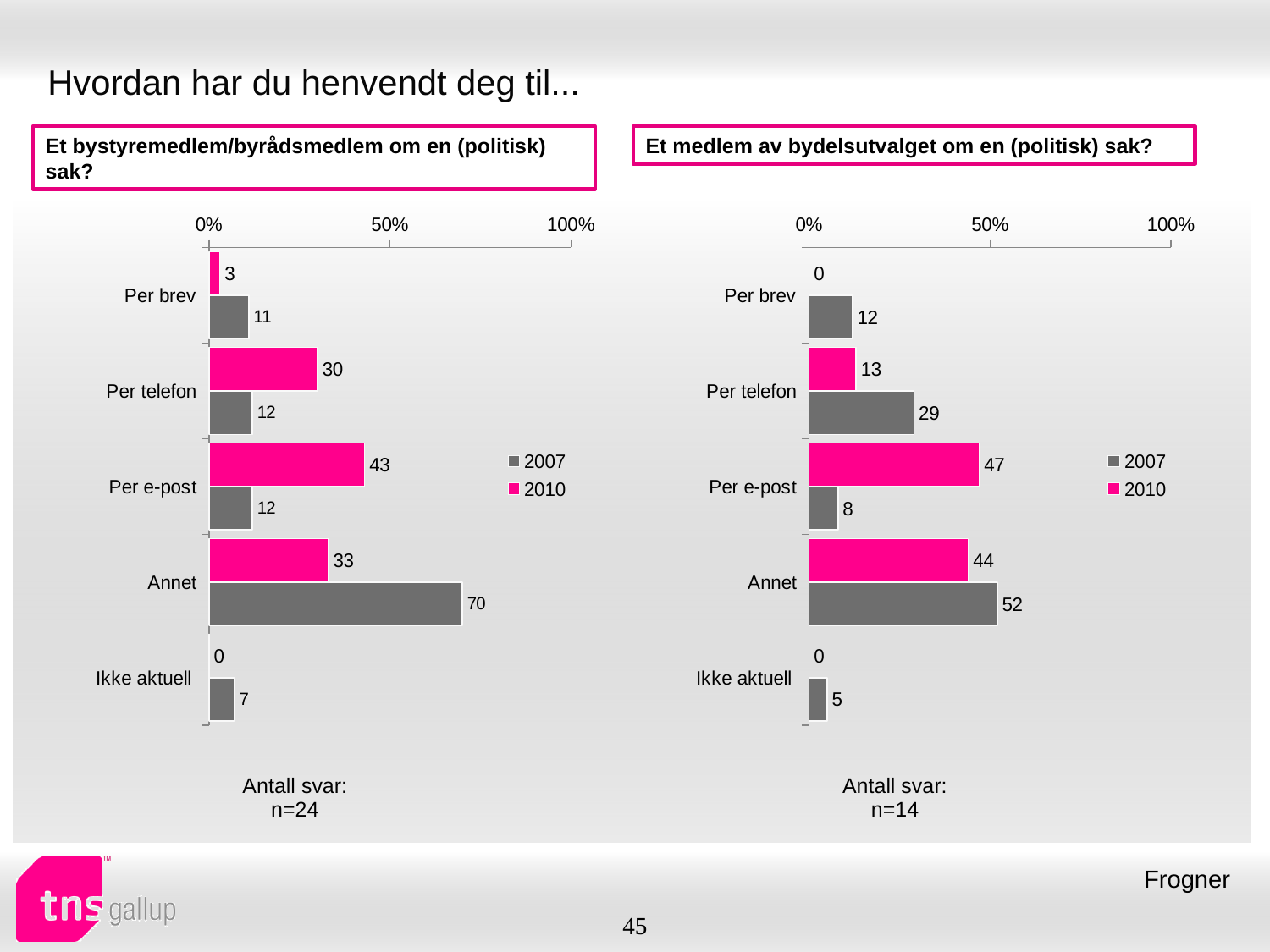
In the right chart (Et medlem av bydelsutvalget om en (politisk) sak?), what is the difference between the 2010 and 2007 values for Per e-post? 39 How many categories are shown in the left chart (Et bystyremedlem/byrådsmedlem om en (politisk) sak?)? 5 In the left chart (Et bystyremedlem/byrådsmedlem om en (politisk) sak?), what is the 2007 value for Annet? 70 In the left chart (Et bystyremedlem/byrådsmedlem om en (politisk) sak?), what is the difference between the 2007 and 2010 values for Annet? 37 In the right chart (Et medlem av bydelsutvalget om en (politisk) sak?), which category has the lowest 2007 value? Ikke aktuell What kind of chart is the left chart (Et bystyremedlem/byrådsmedlem om en (politisk) sak?)? Bar chart In the right chart (Et medlem av bydelsutvalget om en (politisk) sak?), what is the 2007 value for Per telefon? 29 How many series does the legend of the right chart (Et medlem av bydelsutvalget om en (politisk) sak?) list? 2 In the right chart (Et medlem av bydelsutvalget om en (politisk) sak?), which is larger for Annet: the 2007 value or the 2010 value? 2007 In the left chart (Et bystyremedlem/byrådsmedlem om en (politisk) sak?), which category has the highest 2010 value? Per e-post In the right chart (Et medlem av bydelsutvalget om en (politisk) sak?), what is the 2010 value for Per brev? 0 In the left chart (Et bystyremedlem/byrådsmedlem om en (politisk) sak?), what is the 2010 value for Per e-post? 43